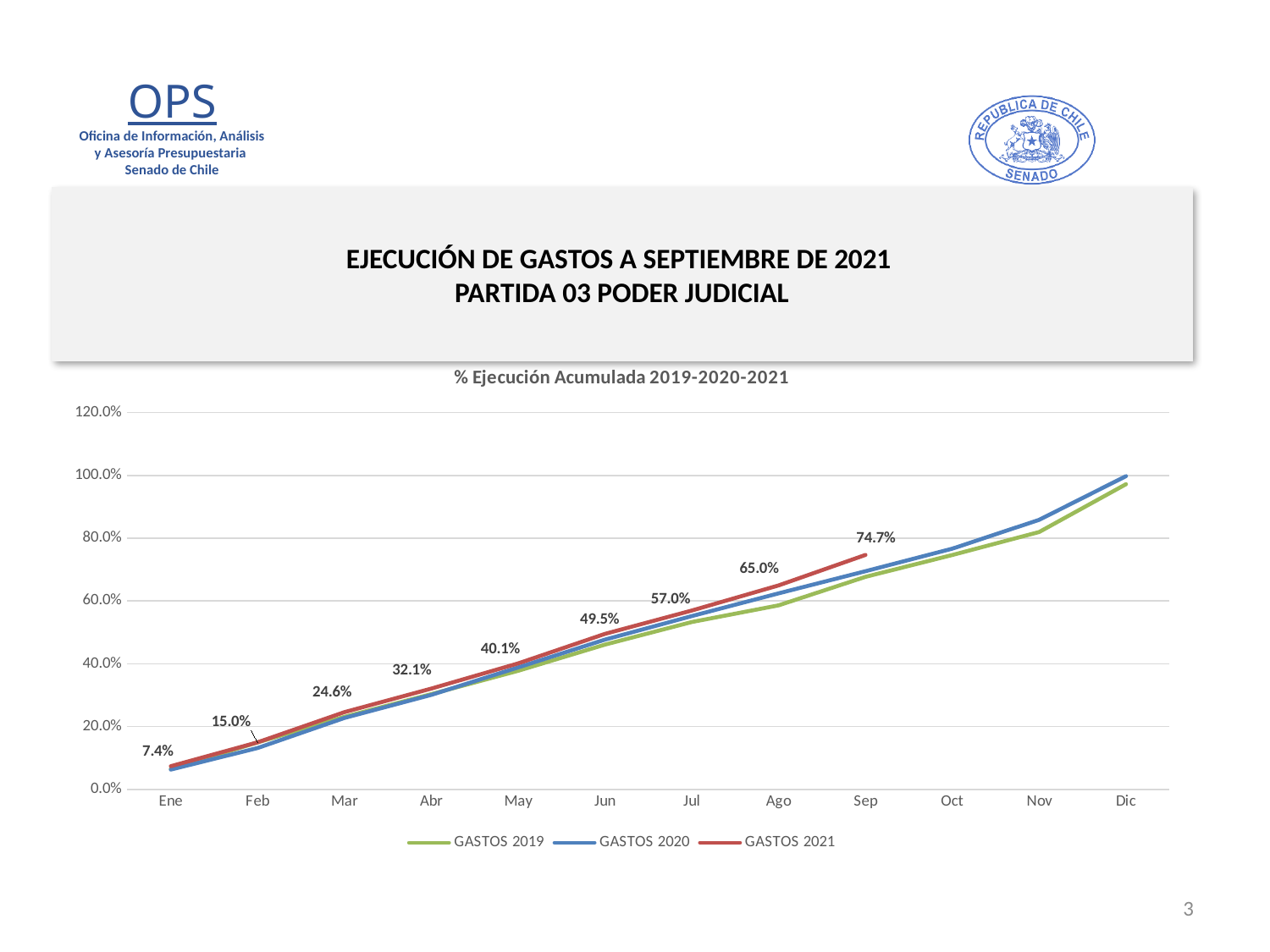
What is the value for GASTOS 2021 in Jul? 57.0% What is the value for GASTOS 2021 in Ene? 7.4% Which series is drawn in red? GASTOS 2021 What is the title of the chart? % Ejecución Acumulada 2019-2020-2021 Do the GASTOS 2021 values rise or fall from Ene to Sep? rise What type of chart is shown on the slide? line chart What is the value for GASTOS 2021 in Sep? 74.7% How many series does the legend list? 3 What is the difference between the GASTOS 2021 values for Sep and Ago? 9.7% Is the value for GASTOS 2020 in Dic greater or less than 80.0%? greater What is the value for GASTOS 2021 in May? 40.1% How many months are shown on the x axis? 12